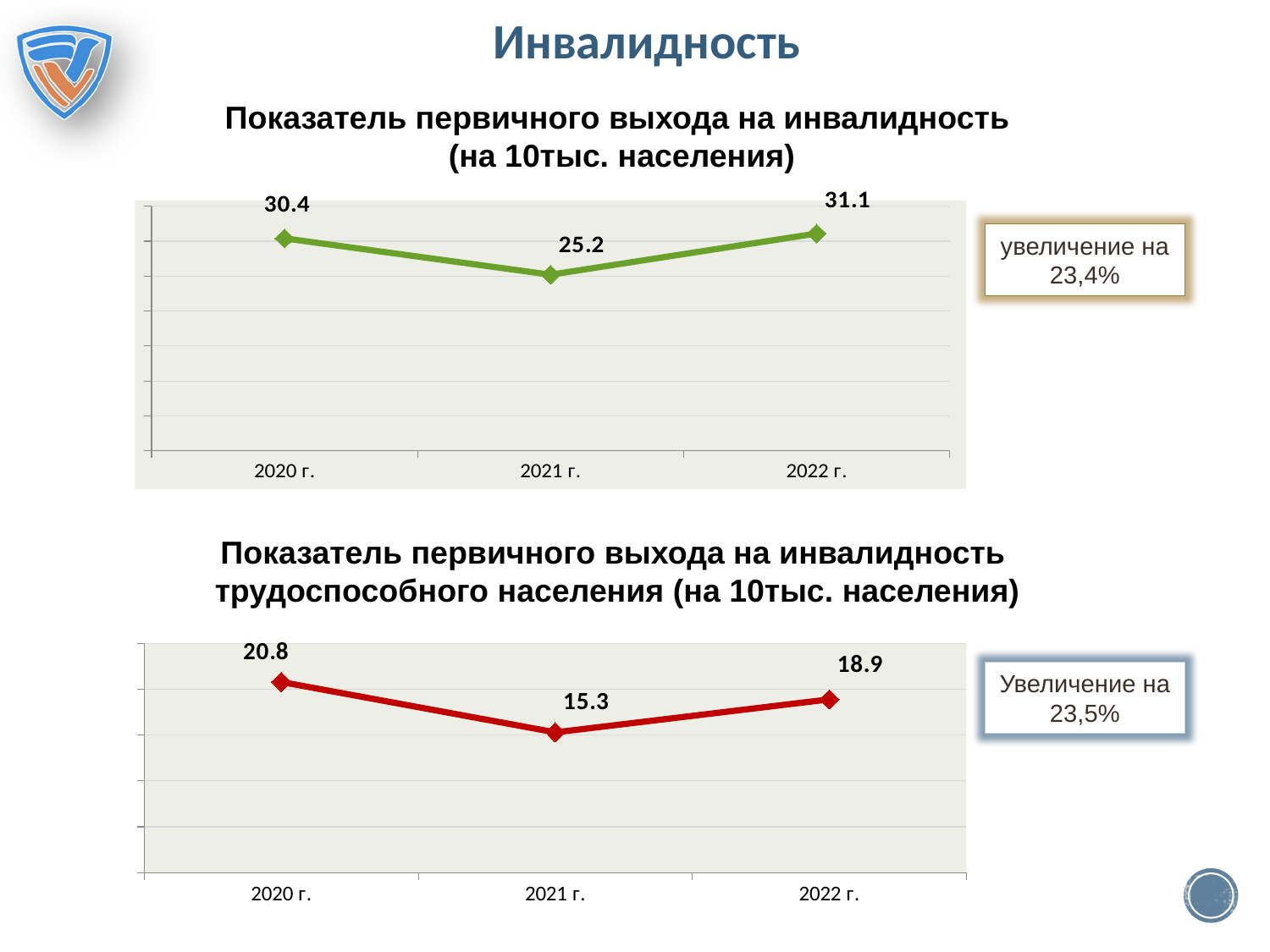
In the bottom chart (трудоспособного населения), what is the difference between the 2020 г. and 2021 г. values? 5.5 In the bottom chart (трудоспособного населения), what is the value for 2021 г.? 15.3 In the top chart (Показатель первичного выхода на инвалидность), what is the value for 2022 г.? 31.1 In the top chart (Показатель первичного выхода на инвалидность), which year has the lowest value? 2021 г. In the bottom chart (трудоспособного населения), which year has the lowest value? 2021 г. In the bottom chart (трудоспособного населения), which is larger: the value for 2020 г. or 2022 г.? 2020 г. In the top chart (Показатель первичного выхода на инвалидность), what is the difference between the 2022 г. and 2021 г. values? 5.9 How many data points are plotted in the top chart (Показатель первичного выхода на инвалидность)? 3 In the bottom chart (трудоспособного населения), what is the value for 2020 г.? 20.8 What type of chart is the bottom chart (трудоспособного населения)? Line chart In the top chart (Показатель первичного выхода на инвалидность), which year has the highest value? 2022 г. In the top chart (Показатель первичного выхода на инвалидность), what is the value for 2021 г.? 25.2